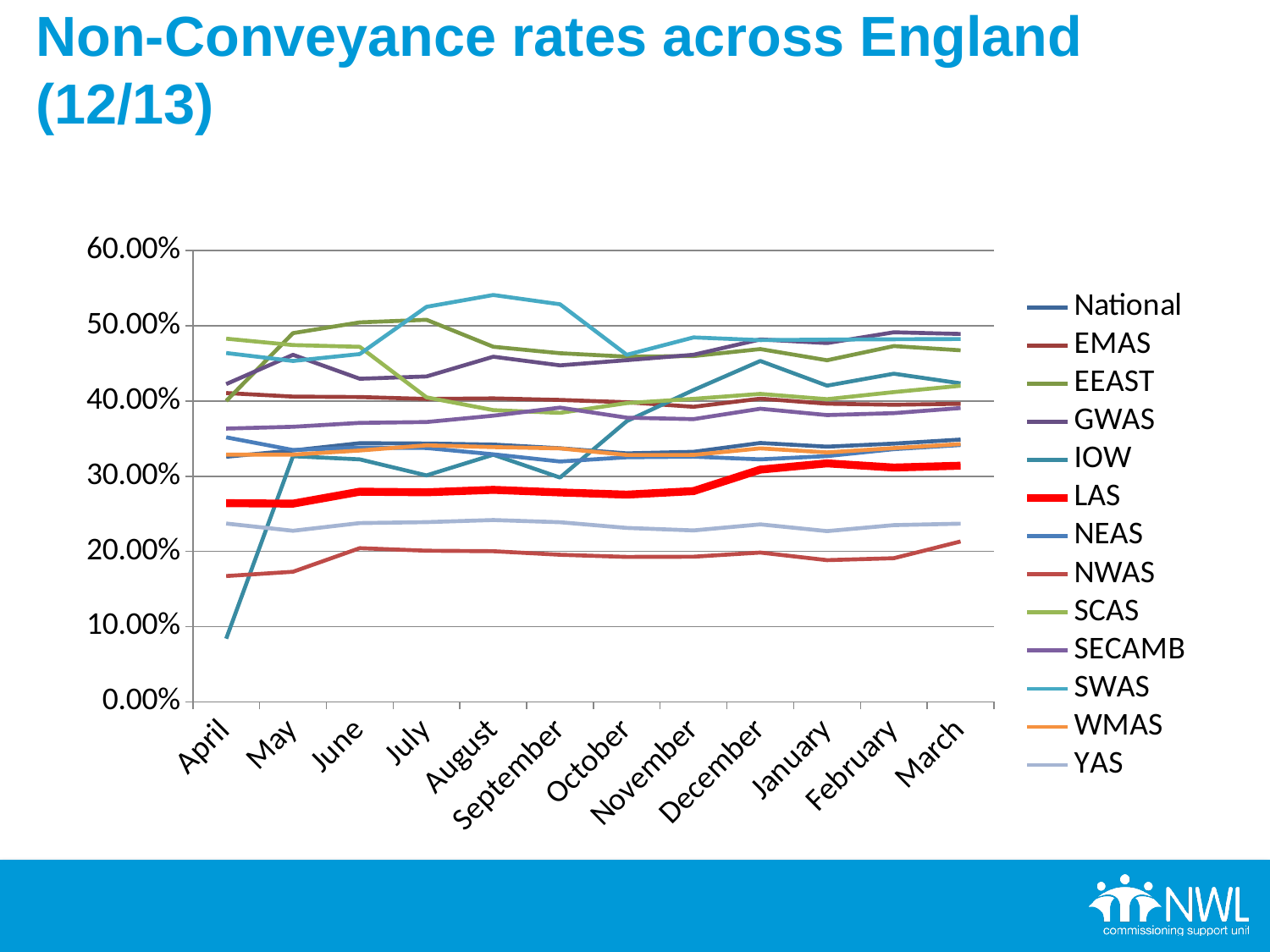
How many months are plotted along the x axis? 12 What kind of chart is shown on the slide? line chart Which series is drawn with the thick red line? LAS Is the value for SWAS in August greater or less than 50.00%? greater Is the value for IOW in April greater or less than 10.00%? less Which series has the lowest value in April? IOW Which series has the highest value in August? SWAS What is the title of the chart on the slide? Non-Conveyance rates across England (12/13) How many series does the legend list? 13 Does the LAS line rise or fall overall from April to March? rise Is the value for NWAS in April greater or less than 20.00%? less Which is larger in April, the value for LAS or the value for NWAS? LAS